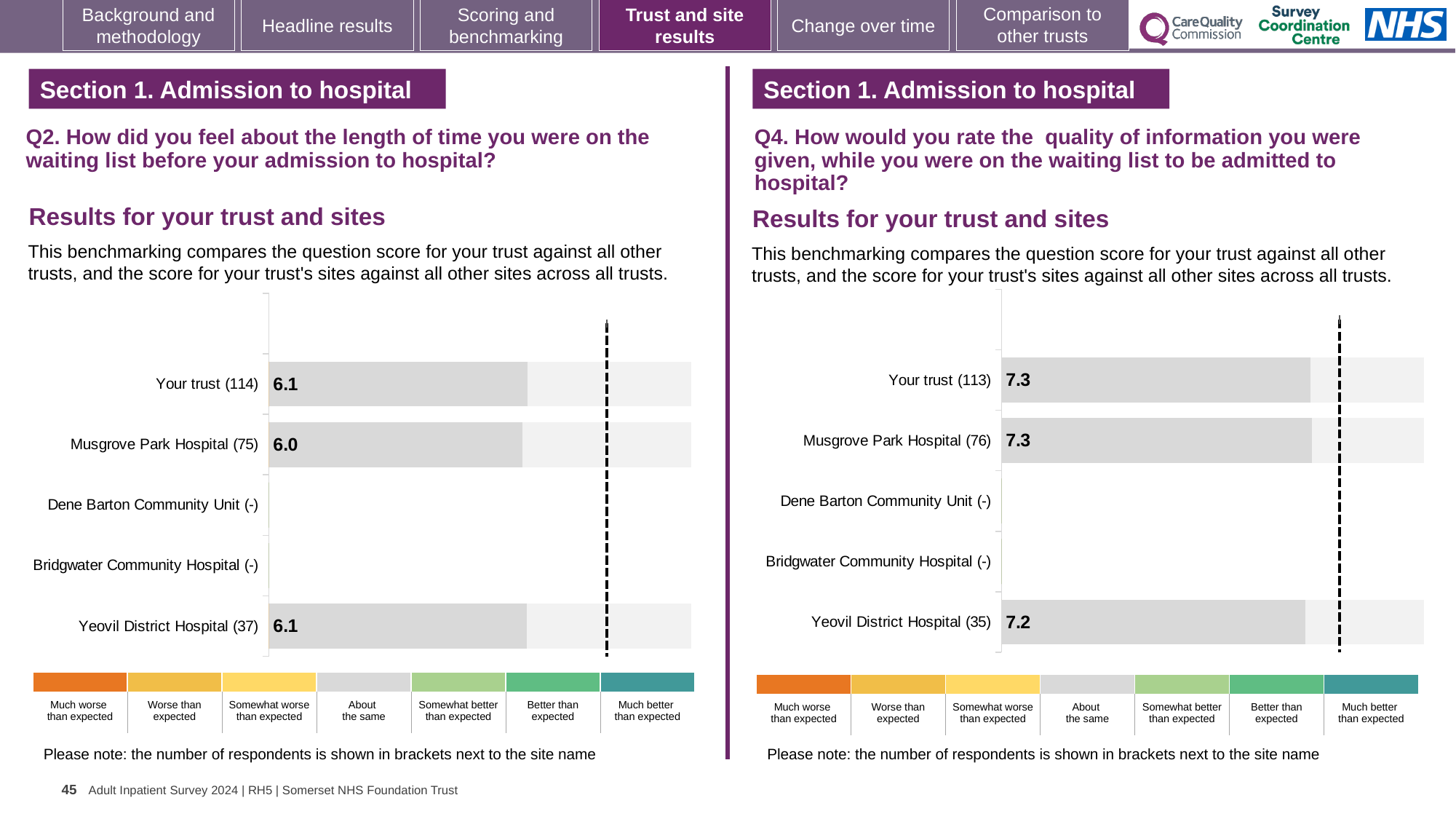
On the left chart (Q2), what is the score for Yeovil District Hospital? 6.1 How many site or trust categories are listed on the left chart (Q2)? 5 On the left chart (Q2), what is the difference between the score for Your trust and the score for Musgrove Park Hospital? 0.1 On the right chart (Q4), what is the score for Musgrove Park Hospital? 7.3 On the right chart (Q4), what is the score for Yeovil District Hospital? 7.2 On the left chart (Q2), what is the score for Musgrove Park Hospital? 6.0 On the right chart (Q4), which has the higher score, Your trust or Yeovil District Hospital? Your trust On the right chart (Q4), what is the score for Your trust? 7.3 On the right chart (Q4), what is the difference between the score for Musgrove Park Hospital and the score for Yeovil District Hospital? 0.1 On the left chart (Q2), which has the lower score, Musgrove Park Hospital or Yeovil District Hospital? Musgrove Park Hospital What kind of chart is used on the right (Q4)? Bar chart On the left chart (Q2), what is the score for Your trust? 6.1